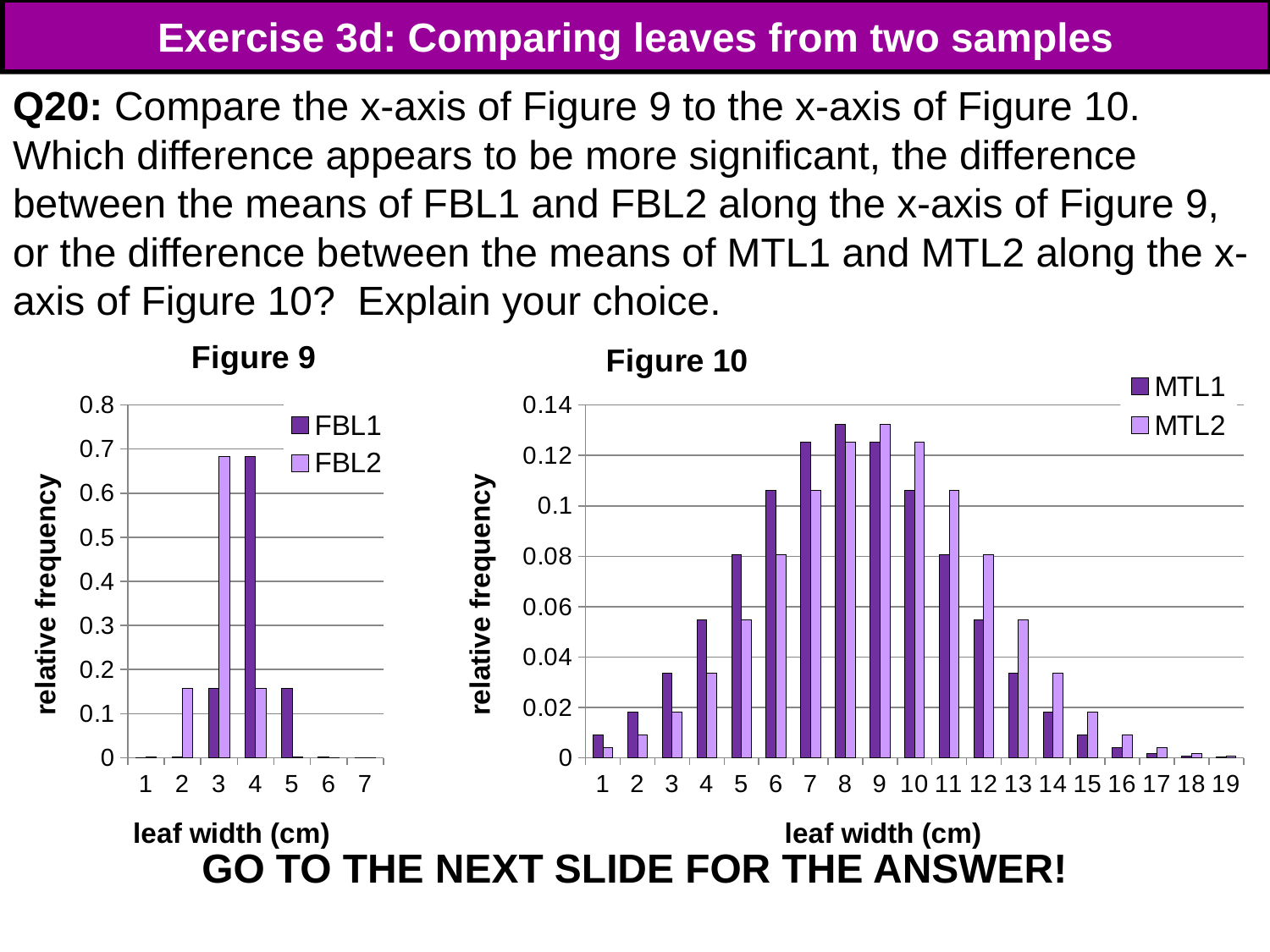
In Figure 9, at leaf width 3, which series has the larger relative frequency, FBL1 or FBL2? FBL2 In Figure 10, at which leaf width is the MTL1 relative frequency highest? 8 In Figure 9, is the FBL1 value at leaf width 4 greater or less than 0.6? greater In Figure 10, at which leaf width is the MTL2 relative frequency highest? 9 In Figure 9, what kind of chart is shown? bar chart In Figure 9, at which leaf width is the FBL2 relative frequency highest? 3 In Figure 10, how many leaf width categories are shown on the x-axis? 19 In Figure 10, what is the label on the y-axis? relative frequency In Figure 9, how many leaf width categories are shown on the x-axis? 7 In Figure 9, how many series does the legend list? 2 In Figure 10, is the MTL1 value at leaf width 1 greater or less than 0.02? less